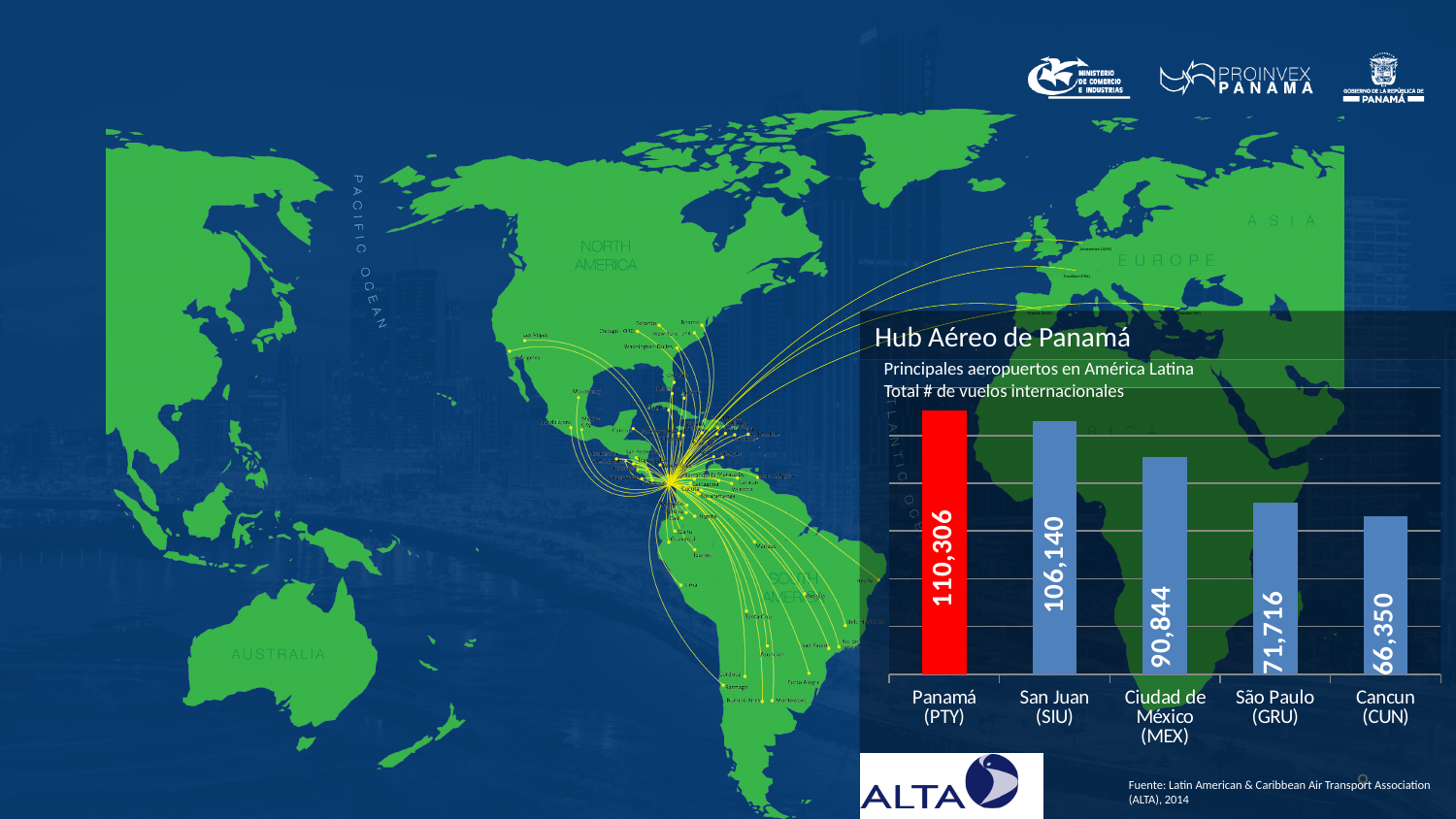
Which has a larger value, Ciudad de México (MEX) or São Paulo (GRU)? Ciudad de México (MEX) What value is shown for Cancun (CUN)? 66,350 Which airport has the highest number of international flights in the chart? Panamá (PTY) Which airport has the lowest number of international flights in the chart? Cancun (CUN) What is the title of the chart? Hub Aéreo de Panamá What is the total number of international flights shown for Panamá (PTY)? 110,306 What value is shown for San Juan (SIU)? 106,140 What is the difference between the values for São Paulo (GRU) and Cancun (CUN)? 5,366 What value is shown for Ciudad de México (MEX)? 90,844 What kind of chart is used on the slide? Bar chart How many airports are shown in the chart? 5 What is the difference between the values for Panamá (PTY) and San Juan (SIU)? 4,166